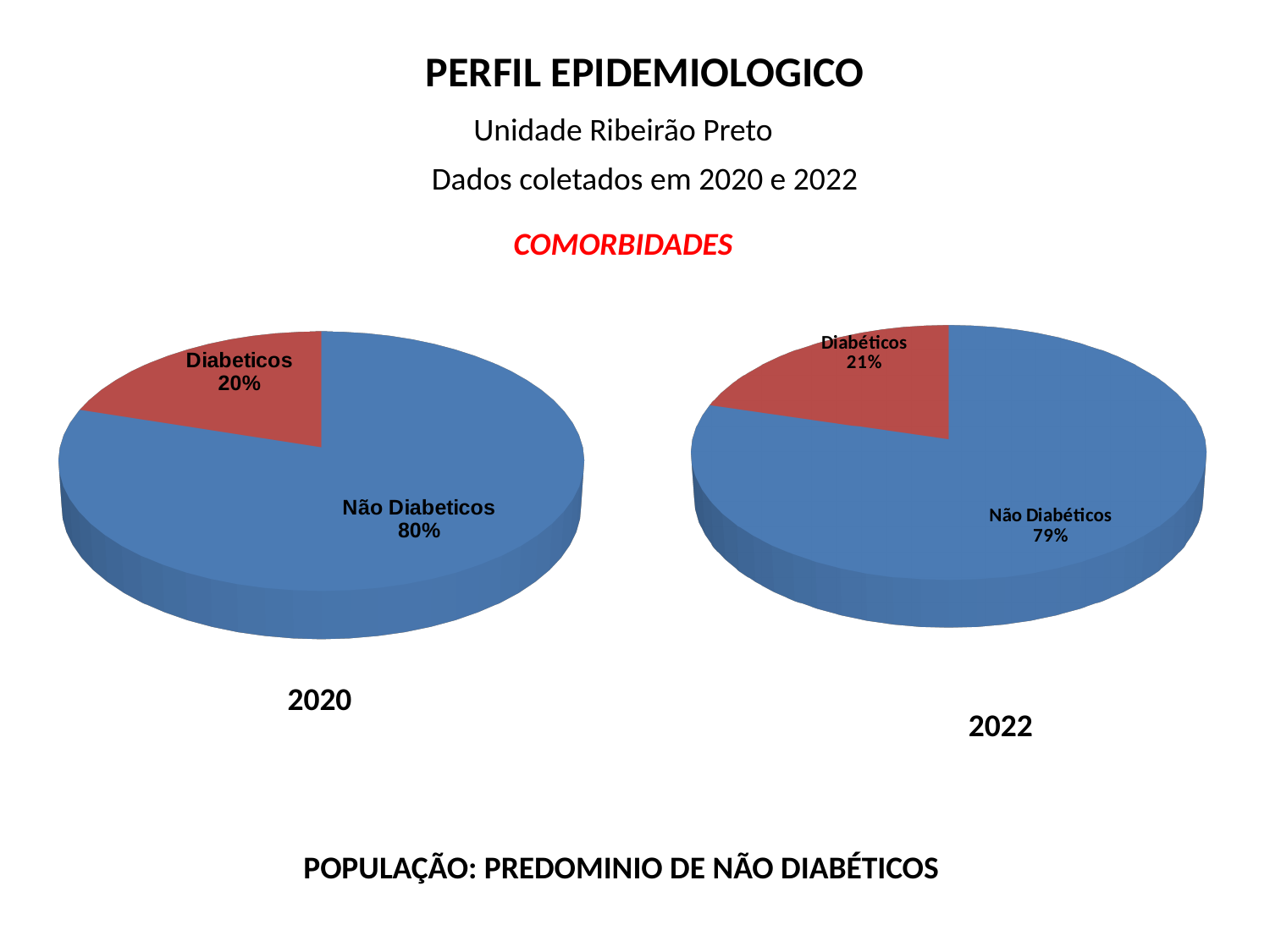
What colour is the Diabéticos slice in the 2022 pie chart? Red In the 2020 pie chart, which slice is the largest? Não Diabeticos In the 2020 pie chart, what percentage is labelled for Diabeticos? 20% In the 2022 pie chart, what percentage is labelled for Diabéticos? 21% In the 2022 pie chart, which slice is the smallest? Diabéticos In the 2022 pie chart, what percentage is labelled for Não Diabéticos? 79% Which is larger: the Diabéticos share in the 2022 chart or the Diabeticos share in the 2020 chart? 2022 (21%) In the 2022 pie chart, what is the difference in percentage points between Não Diabéticos and Diabéticos? 58 In the 2020 pie chart, what is the difference in percentage points between Não Diabeticos and Diabeticos? 60 How many slices does the 2020 pie chart have? 2 What type of chart is used for the 2022 data? Pie chart In the 2020 pie chart, what percentage is labelled for Não Diabeticos? 80%